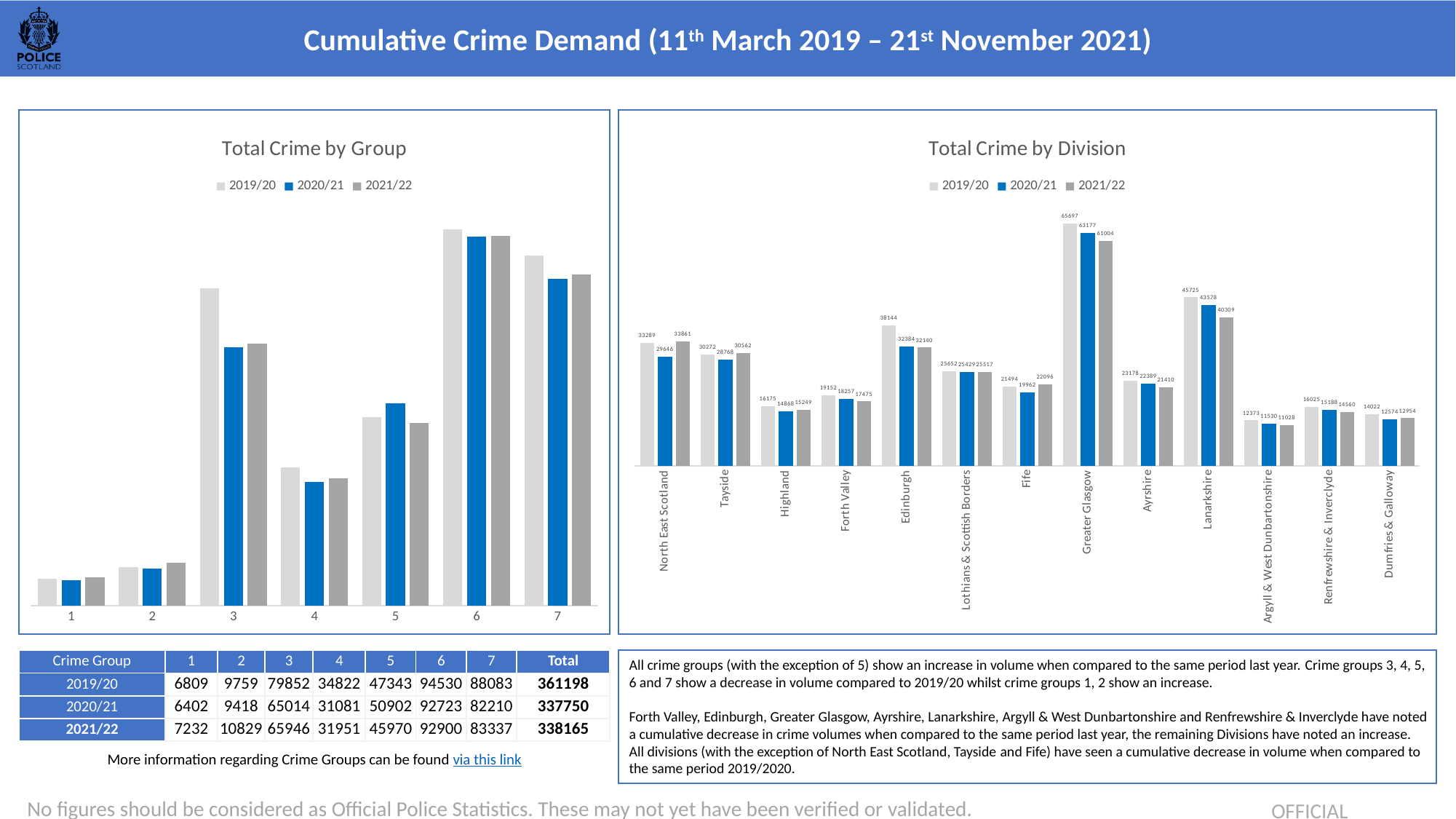
In the 'Total Crime by Division' chart, which division has the highest 2019/20 value? Greater Glasgow What kind of chart is the 'Total Crime by Group' chart? bar chart What are the legend entries of the 'Total Crime by Group' chart? 2019/20, 2020/21, 2021/22 How many series does the legend of the 'Total Crime by Division' chart list? 3 In the 'Total Crime by Group' chart, which crime group has the highest 2019/20 bar? 6 In the 'Total Crime by Division' chart, which division has the lowest 2021/22 value? Argyll & West Dunbartonshire In the 'Total Crime by Division' chart, what is the difference between the 2019/20 and 2021/22 values for Greater Glasgow? 4693 In the 'Total Crime by Division' chart, what is the 2019/20 value for Edinburgh? 38144 How many crime groups are shown on the x axis of the 'Total Crime by Group' chart? 7 In the 'Total Crime by Division' chart, which is larger for Fife: the 2019/20 value or the 2021/22 value? 2021/22 In the 'Total Crime by Division' chart, what is the 2021/22 value for Lanarkshire? 40309 How many divisions are shown on the x axis of the 'Total Crime by Division' chart? 13